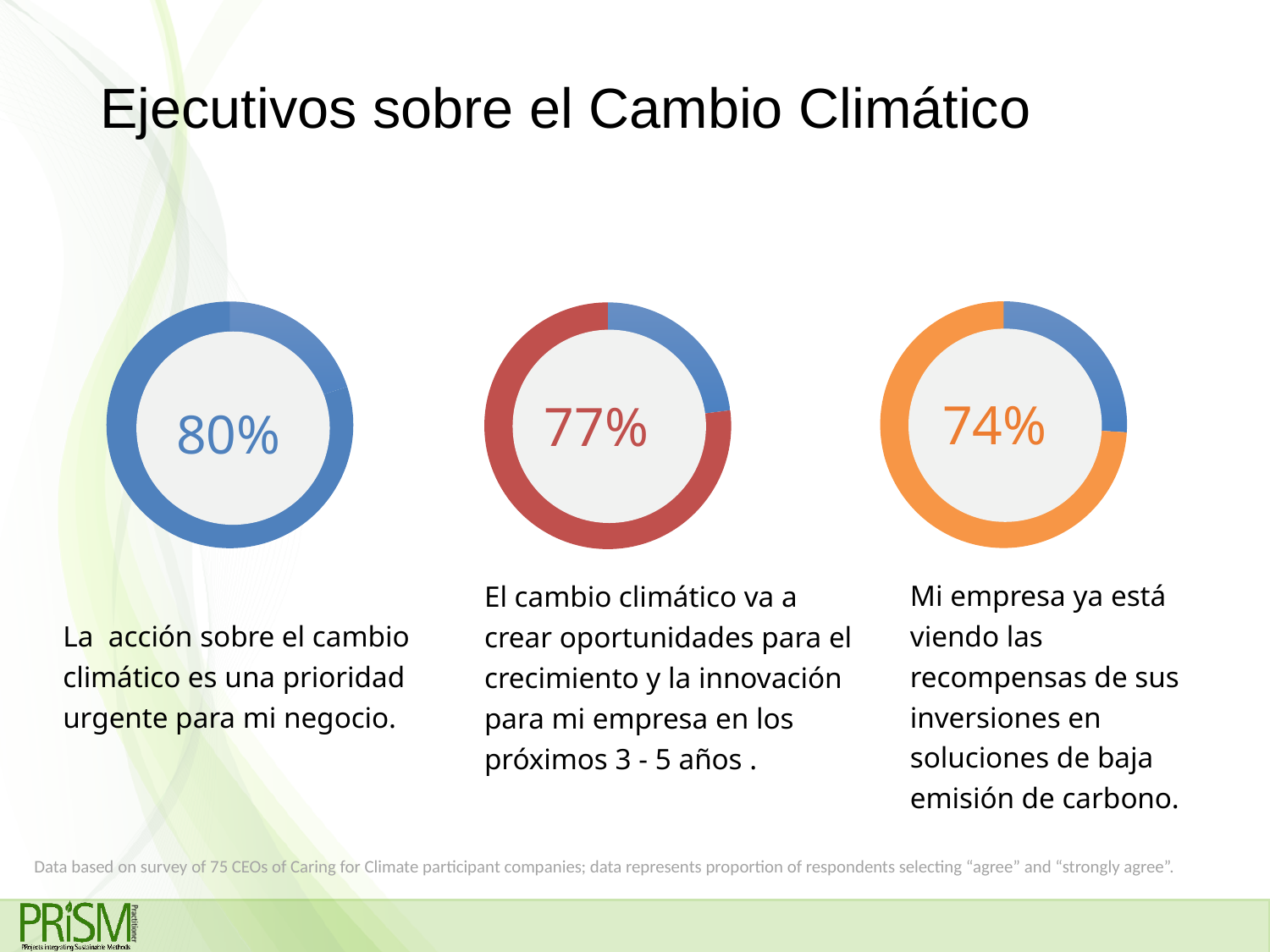
What is the difference between the percentage in the left doughnut chart and the percentage in the middle doughnut chart? 3% What colour is the filled portion of the middle doughnut chart? Red Which of the three doughnut charts shows the lowest percentage? The right chart (74%) How many doughnut charts are shown on the slide? 3 What percentage is shown in the left doughnut chart, for 'La acción sobre el cambio climático es una prioridad urgente para mi negocio'? 80% What percentage is shown in the right doughnut chart, for 'Mi empresa ya está viendo las recompensas de sus inversiones en soluciones de baja emisión de carbono'? 74% Which of the three doughnut charts shows the highest percentage? The left chart (80%) Which is larger: the percentage in the middle doughnut chart or the percentage in the right doughnut chart? The middle chart (77%) What colour is the filled portion of the right doughnut chart? Orange What kind of chart is used to display the three percentages on the slide? Doughnut chart What is the difference between the percentage in the left doughnut chart and the percentage in the right doughnut chart? 6% What percentage is shown in the middle doughnut chart, for 'El cambio climático va a crear oportunidades para el crecimiento y la innovación'? 77%